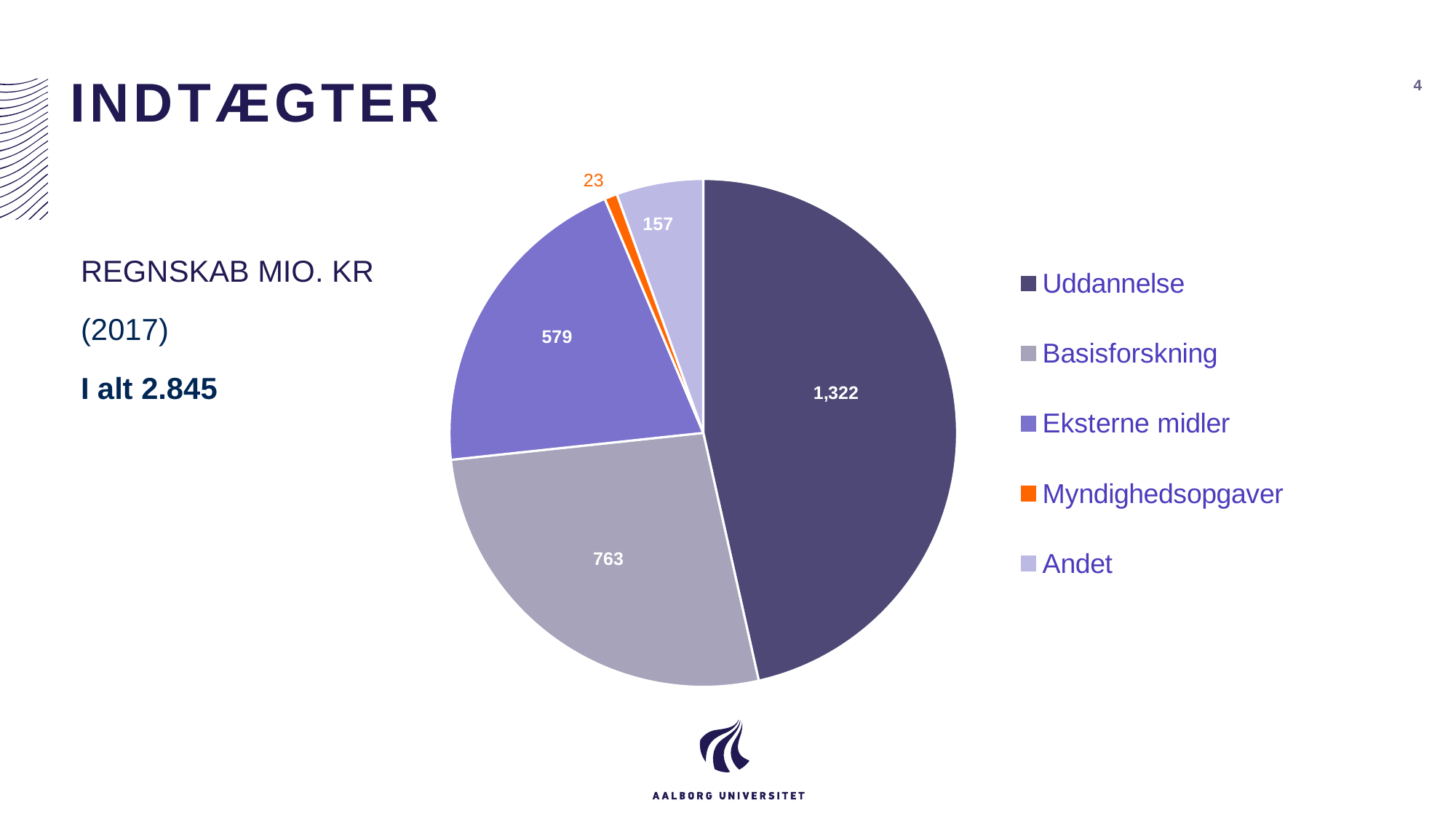
What type of chart is shown on the slide? Pie chart What is the difference between the values for Basisforskning and Eksterne midler? 184 Which is larger, the value for Andet or the value for Myndighedsopgaver? Andet What is the difference between the values for Uddannelse and Basisforskning? 559 Which category has the largest slice of the pie? Uddannelse Which category has the smallest slice of the pie? Myndighedsopgaver What is the value for Eksterne midler? 579 What is the value for Basisforskning? 763 How many categories does the legend list? 5 What is the value for Uddannelse? 1,322 What is the value for Myndighedsopgaver? 23 What is the value for Andet? 157